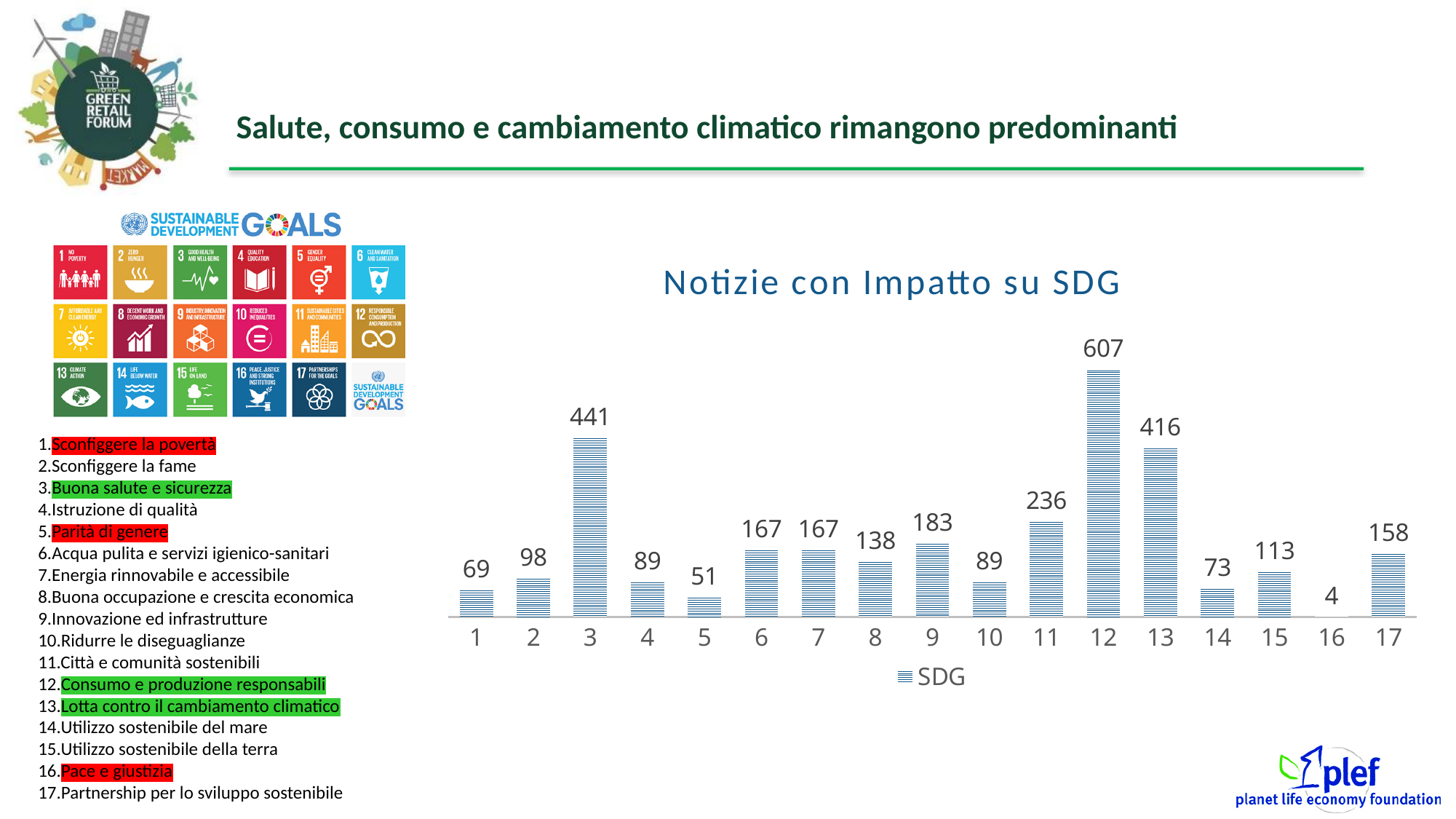
What is the name of the series in the chart legend? SDG How many SDG categories are shown on the x axis of the chart? 17 What is the title of the chart? Notizie con Impatto su SDG What is the value for SDG 12 in the chart? 607 Which has a larger value, SDG 11 or SDG 9? SDG 11 What is the difference between the values for SDG 12 and SDG 13? 191 How many series does the chart legend list? 1 What kind of chart is shown on the slide? Bar chart What is the value for SDG 3 in the chart? 441 Which SDG has the highest value in the chart? 12 Which SDG has the lowest value in the chart? 16 What is the value for SDG 16 in the chart? 4